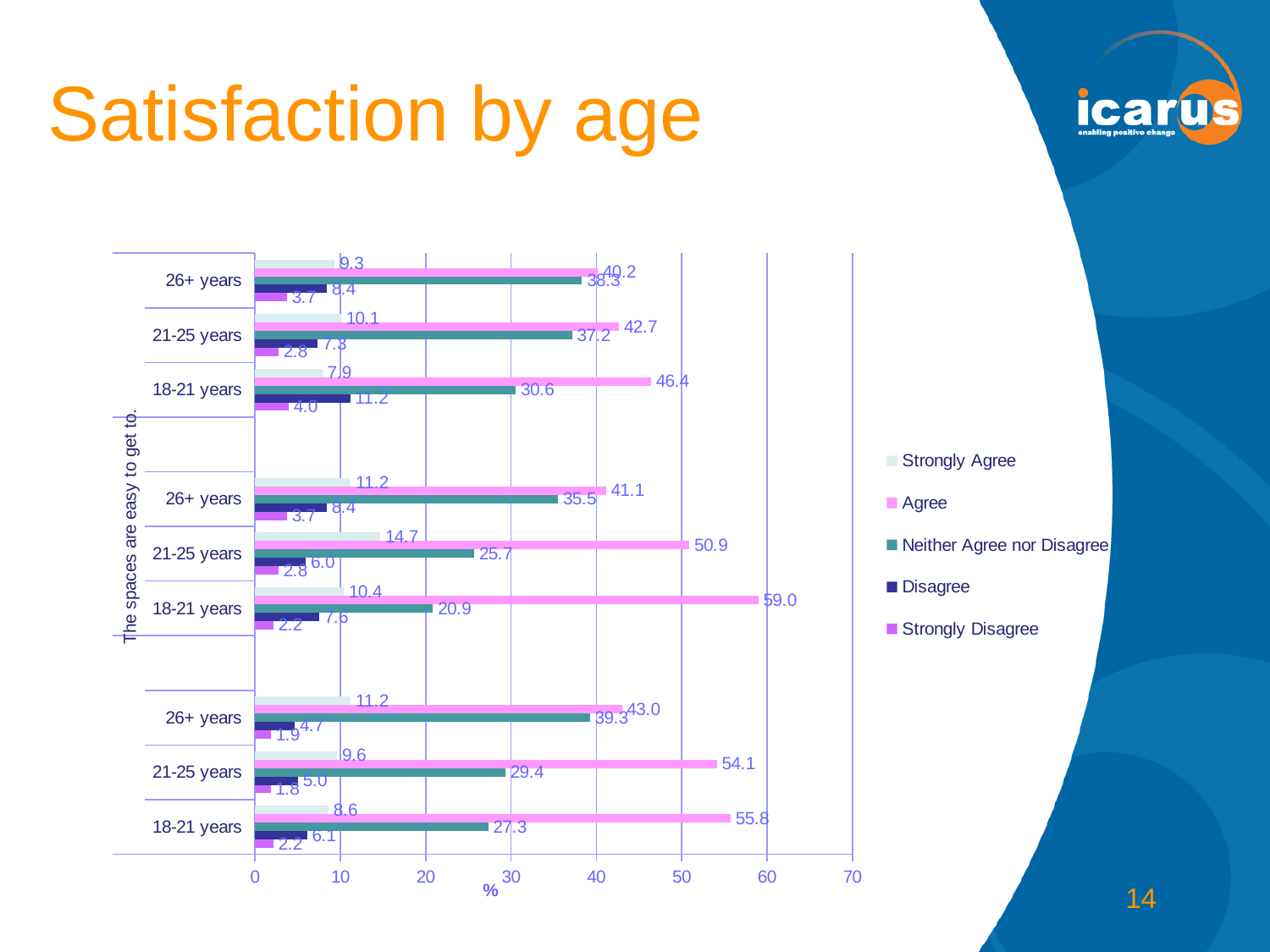
In the group labelled "The spaces are easy to get to.", what is the Strongly Agree value for 21-25 years? 14.7 What label is shown on the x axis of the chart? % What is the title of the slide? Satisfaction by age In the bottom group of bars, what is the Agree value for 21-25 years? 54.1 In the bottom group of bars, which age group has the lowest Strongly Disagree value? 21-25 years In the group labelled "The spaces are easy to get to.", what is the Agree value for 18-21 years? 59.0 What type of chart is shown on the slide? bar chart In the top group of bars, which is larger for 18-21 years: the Agree value or the Neither Agree nor Disagree value? Agree In the top group of bars, what is the Neither Agree nor Disagree value for 26+ years? 38.3 How many series does the legend list? 5 In the group labelled "The spaces are easy to get to.", what is the difference between the Agree values for 18-21 years and 26+ years? 17.9 In the group labelled "The spaces are easy to get to.", which age group has the highest Agree value? 18-21 years